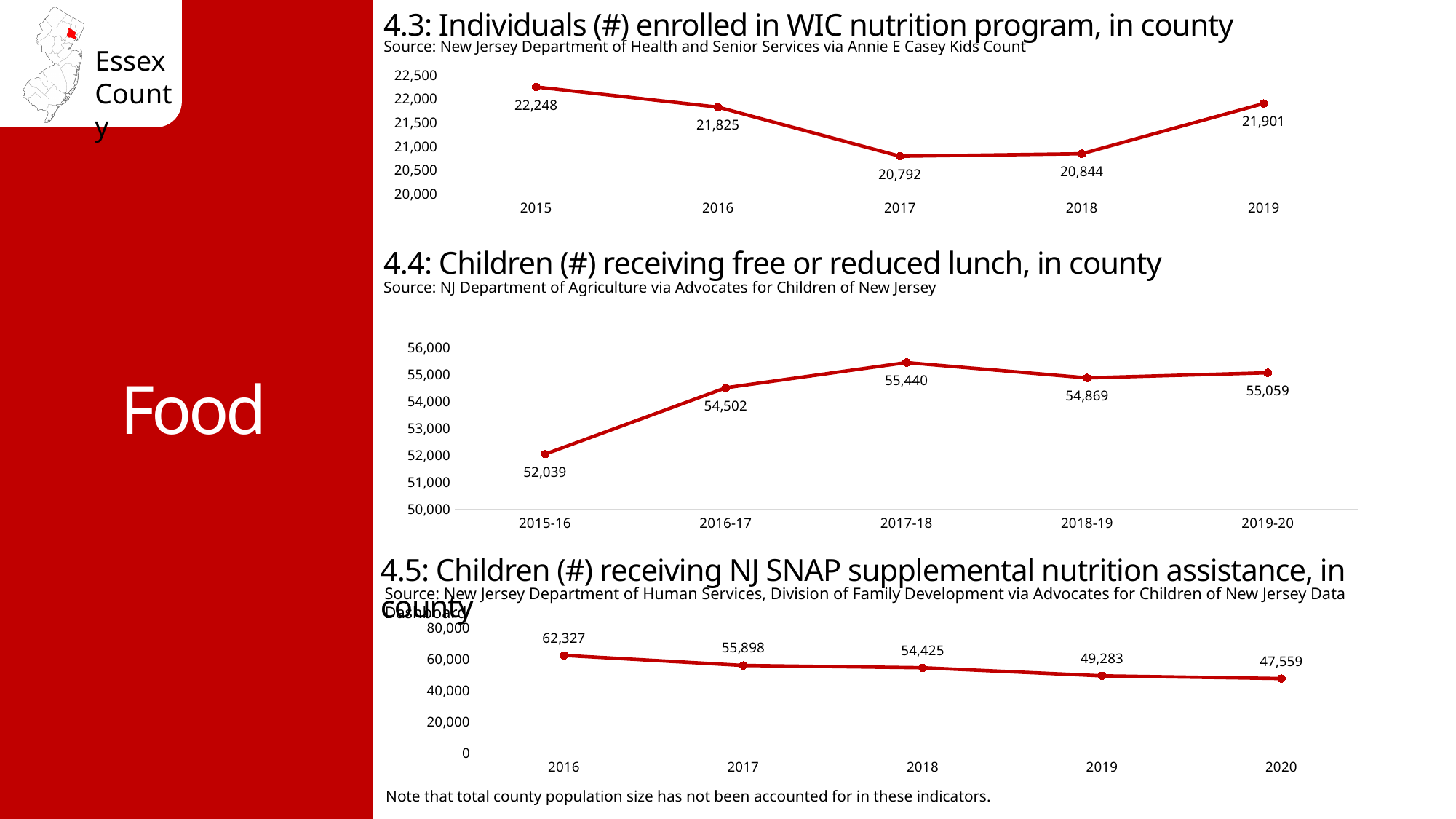
In the chart '4.4: Children (#) receiving free or reduced lunch, in county', which school year has the lowest value? 2015-16 In the chart '4.5: Children (#) receiving NJ SNAP supplemental nutrition assistance, in county', what is the difference between the 2016 and 2020 values? 14,768 In the chart '4.4: Children (#) receiving free or reduced lunch, in county', which is larger, the value for 2017-18 or 2019-20? 2017-18 In the chart '4.3: Individuals (#) enrolled in WIC nutrition program, in county', which year has the highest value? 2015 In the chart '4.4: Children (#) receiving free or reduced lunch, in county', what is the value for 2016-17? 54,502 In the chart '4.5: Children (#) receiving NJ SNAP supplemental nutrition assistance, in county', do the values rise or fall from 2016 to 2020? fall In the chart '4.3: Individuals (#) enrolled in WIC nutrition program, in county', how many data points are plotted? 5 In the chart '4.3: Individuals (#) enrolled in WIC nutrition program, in county', what is the value for 2017? 20,792 In the chart '4.5: Children (#) receiving NJ SNAP supplemental nutrition assistance, in county', what is the value for 2019? 49,283 What type of chart is '4.5: Children (#) receiving NJ SNAP supplemental nutrition assistance, in county'? line chart In the chart '4.4: Children (#) receiving free or reduced lunch, in county', what is the difference between the 2017-18 and 2015-16 values? 3,401 In the chart '4.3: Individuals (#) enrolled in WIC nutrition program, in county', what is the difference between the 2015 and 2019 values? 347